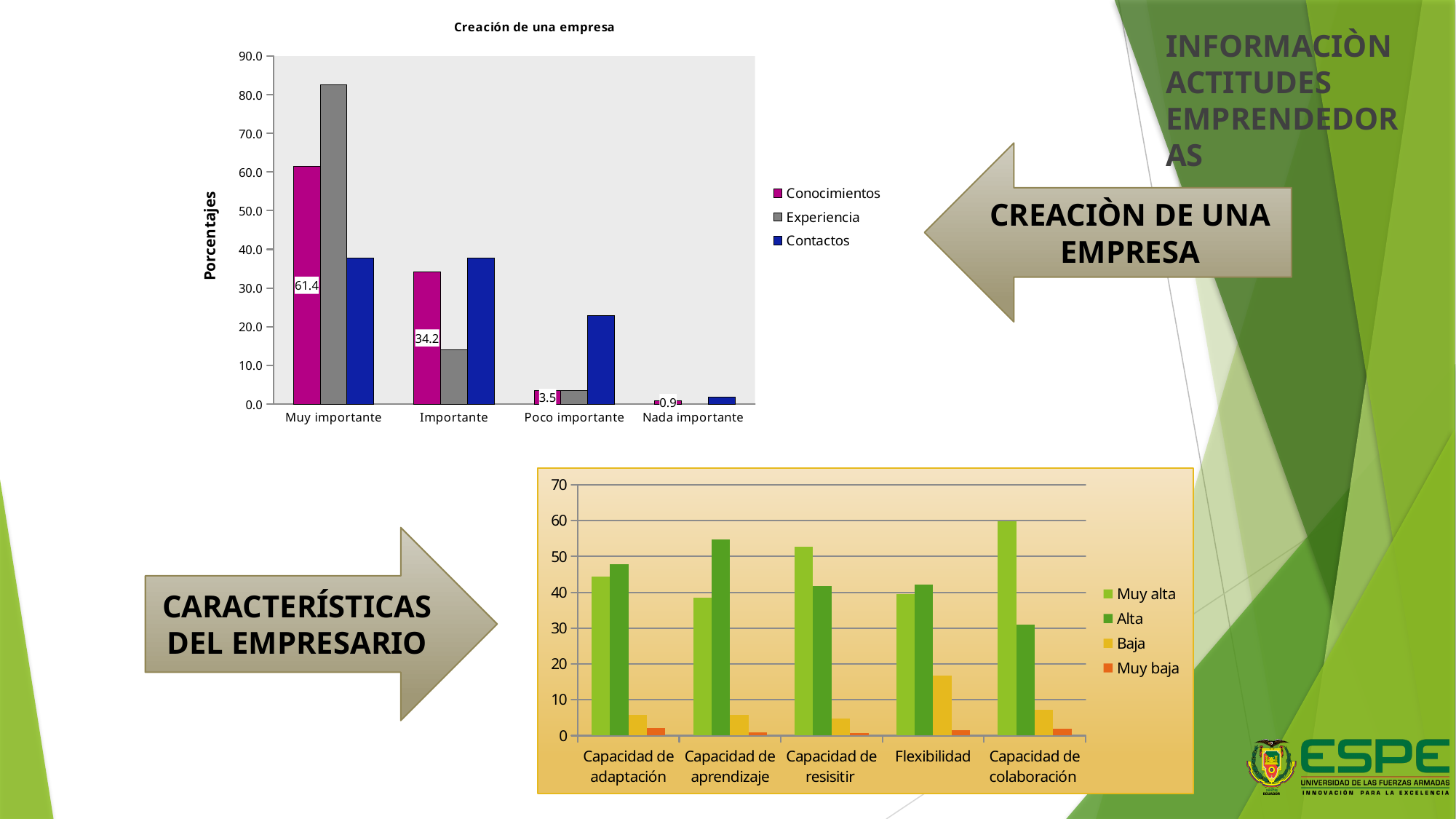
In the 'Creación de una empresa' chart, what is the value for Conocimientos in the 'Importante' category? 34.2 In the 'Creación de una empresa' chart, what is the difference between the Conocimientos values for 'Muy importante' and 'Importante'? 27.2 In the 'Creación de una empresa' chart, which series has the highest value in the 'Muy importante' category? Experiencia In the 'Creación de una empresa' chart, what is the value for Conocimientos in the 'Nada importante' category? 0.9 What kind of chart is the bottom chart (Características del empresario)? bar chart In the bottom chart (Características del empresario), which category has the highest 'Muy alta' value? Capacidad de colaboración In the bottom chart (Características del empresario), is the 'Baja' value for Flexibilidad greater or less than 10? greater In the 'Creación de una empresa' chart, is the value for Experiencia in 'Muy importante' greater or less than 80.0? greater In the 'Creación de una empresa' chart, what is the value for Conocimientos in the 'Muy importante' category? 61.4 In the 'Creación de una empresa' chart, how many series does the legend list? 3 In the bottom chart (Características del empresario), how many categories are shown on the x axis? 5 In the 'Creación de una empresa' chart, what is the label of the y axis? Porcentajes